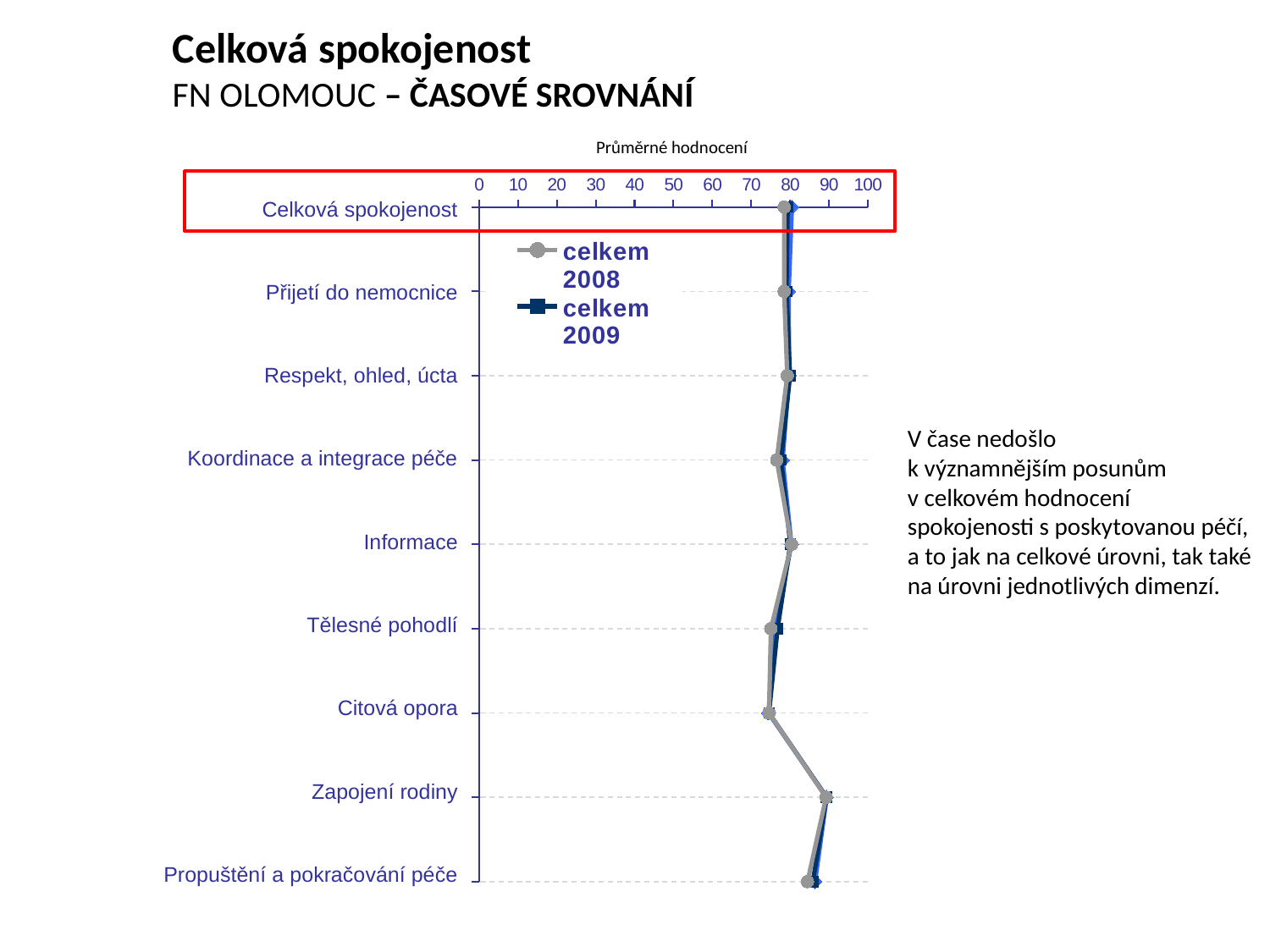
Is the value for Citová opora greater or less than 80? less Is the value for Zapojení rodiny greater or less than 80? greater How many series does the legend list? 2 Is the value for Koordinace a integrace péče greater or less than 80? less What are the two series named in the legend? celkem 2008 and celkem 2009 How many categories are plotted on the chart? 9 What kind of chart is shown on the slide? line chart What is the title shown above the value axis of the chart? Průměrné hodnocení Which has the larger value, Propuštění a pokračování péče or Tělesné pohodlí? Propuštění a pokračování péče Which has the larger value, Zapojení rodiny or Citová opora? Zapojení rodiny Which category has the highest value on the chart? Zapojení rodiny